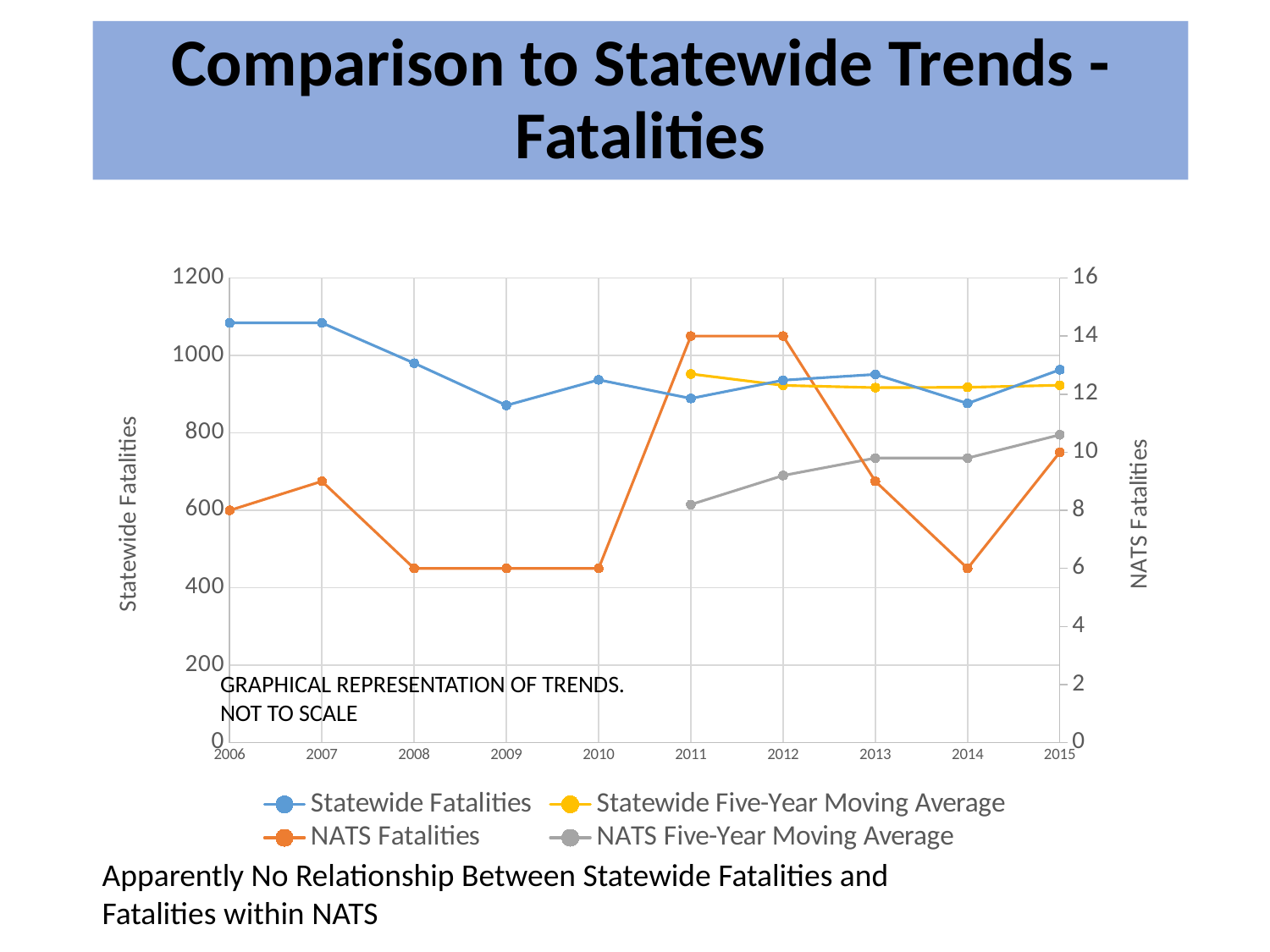
Is the value for NATS Fatalities in 2011 greater or less than 12? greater Is the value for NATS Fatalities in 2014 greater or less than 8? less Which is larger, NATS Fatalities in 2011 or in 2014? 2011 Do Statewide Fatalities rise or fall from 2006 to 2009? fall What kind of chart is shown on the slide? line chart Is the value for Statewide Fatalities in 2009 greater or less than 900? less What is the title of the right-hand vertical axis? NATS Fatalities How many years are plotted along the x axis? 10 How many series does the legend list? 4 Which is larger, Statewide Fatalities in 2006 or in 2009? 2006 Does the NATS Five-Year Moving Average rise or fall from 2011 to 2015? rise